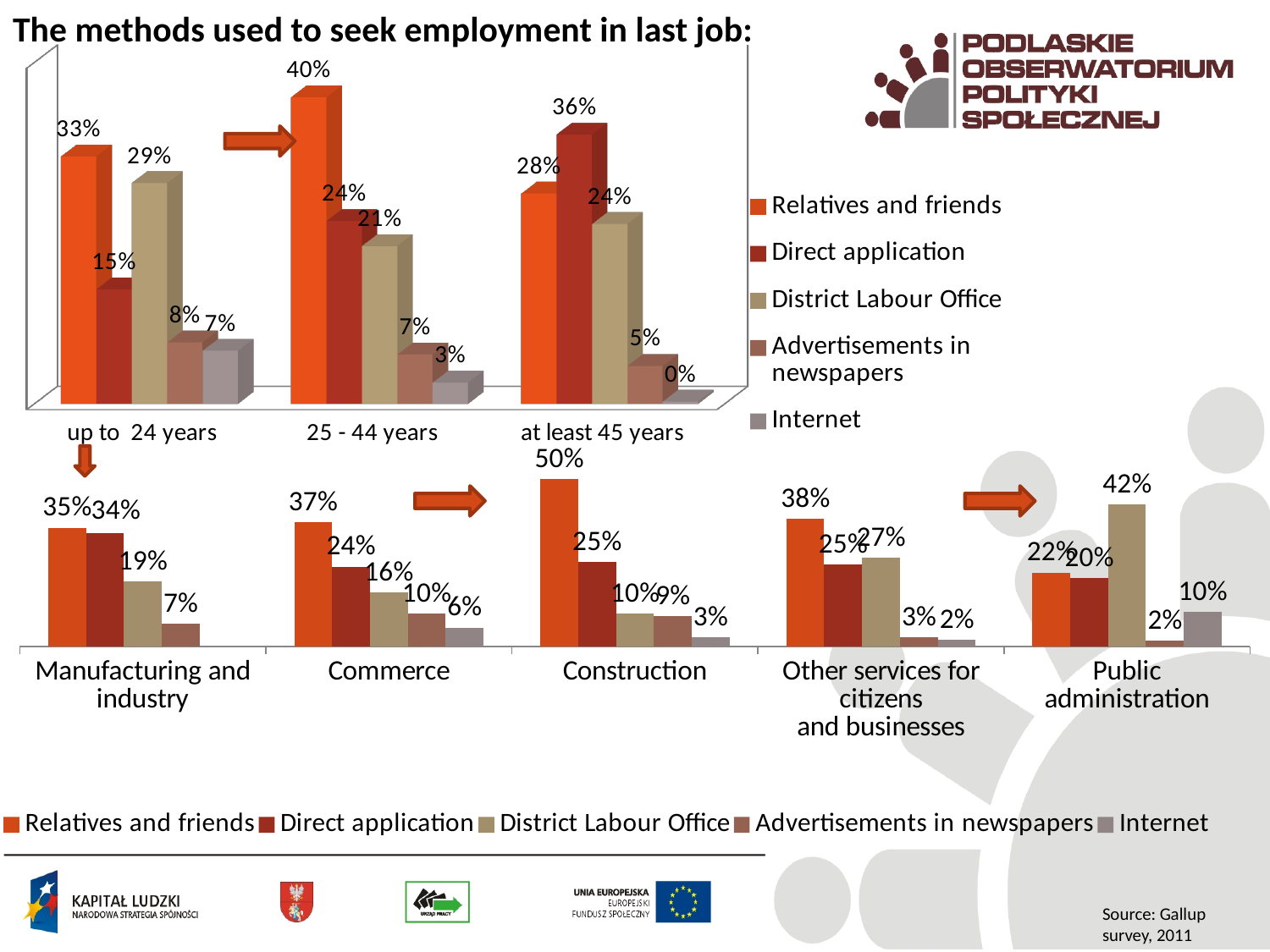
In the top chart (by age group), how many age groups are shown? 3 In the bottom chart (by sector), what is the value for District Labour Office in Public administration? 42% In the top chart (by age group), what is the value for Relatives and friends in the 25 - 44 years group? 40% In the bottom chart (by sector), which sector has the highest value for Relatives and friends? Construction In the bottom chart (by sector), what is the difference between Relatives and friends and Direct application in Construction? 25 percentage points How many series does the legend of the bottom chart list? 5 What type of chart is the bottom chart (by sector)? Bar chart In the top chart (by age group), which method has the highest value for the up to 24 years group? Relatives and friends In the bottom chart (by sector), which is larger in Other services for citizens and businesses: Direct application or District Labour Office? District Labour Office In the top chart (by age group), what is the value for Direct application in the at least 45 years group? 36% In the top chart (by age group), what is the value for Internet in the at least 45 years group? 0% In the top chart (by age group), what is the difference between Relatives and friends and Direct application in the up to 24 years group? 18 percentage points